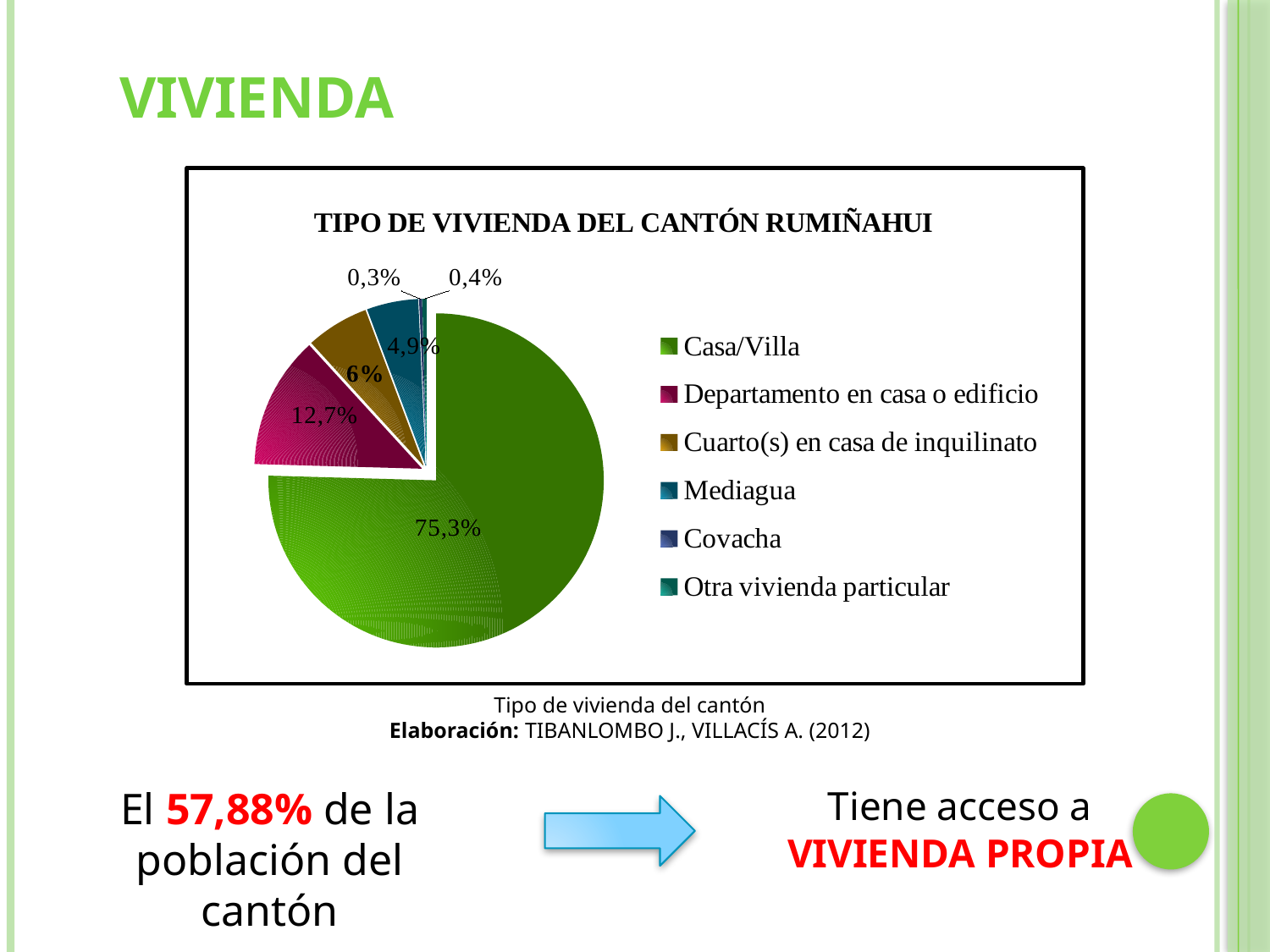
What percentage of the pie corresponds to Casa/Villa? 75,3% Which housing type has the largest share of the pie? Casa/Villa Which is larger, the share for Departamento en casa o edificio or the share for Mediagua? Departamento en casa o edificio What is the difference between the Casa/Villa share and the Departamento en casa o edificio share? 62,6% Which housing type has the smallest share of the pie? Covacha What colour is the Casa/Villa slice in the pie chart? Green What type of chart is shown on the slide? Pie chart What is the value shown for Mediagua? 4,9% What is the title of the chart? TIPO DE VIVIENDA DEL CANTÓN RUMIÑAHUI How many categories does the legend list? 6 What is the value shown for Cuarto(s) en casa de inquilinato? 6% What is the value shown for Departamento en casa o edificio? 12,7%